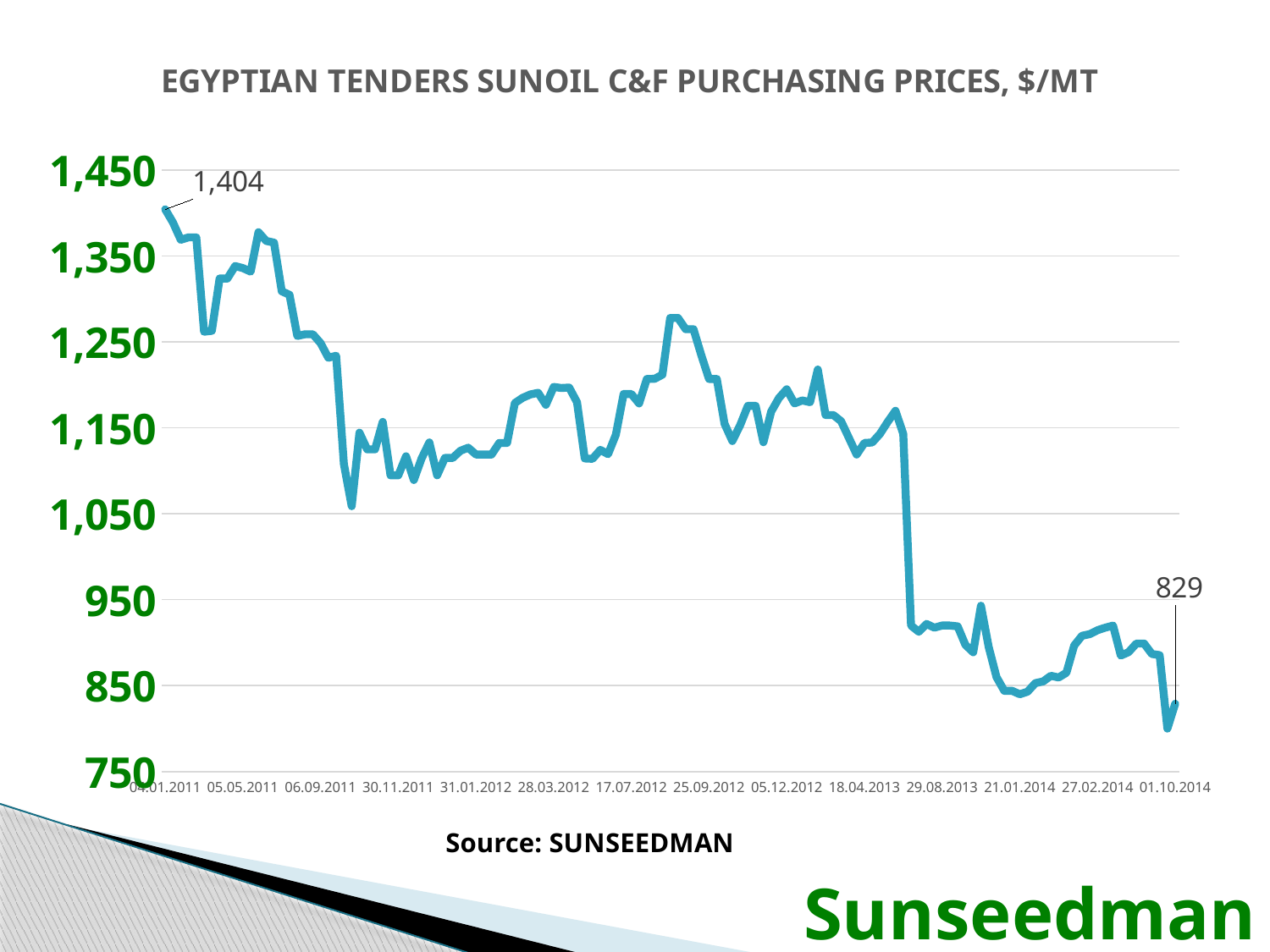
Is the value at 01.10.2014 greater or less than 850? less What is the difference between the labelled value at 04.01.2011 (1,404) and the labelled value at 01.10.2014 (829)? 575 What source is cited below the chart? SUNSEEDMAN What kind of chart is shown on the slide? Line chart How many date labels are shown on the x axis? 14 Is the value at 04.01.2011 greater or less than 1,350? greater What is the value of the last labelled point on the chart, at 01.10.2014? 829 What is the value of the first labelled point on the chart, at 04.01.2011? 1,404 What is the title of the chart? EGYPTIAN TENDERS SUNOIL C&F PURCHASING PRICES, $/MT Is the value at 29.08.2013 greater or less than 950? less Overall, do the prices rise or fall from 2011 to 2014 along the x axis? Fall Which is larger: the labelled value at 04.01.2011 or the labelled value at 01.10.2014? 04.01.2011